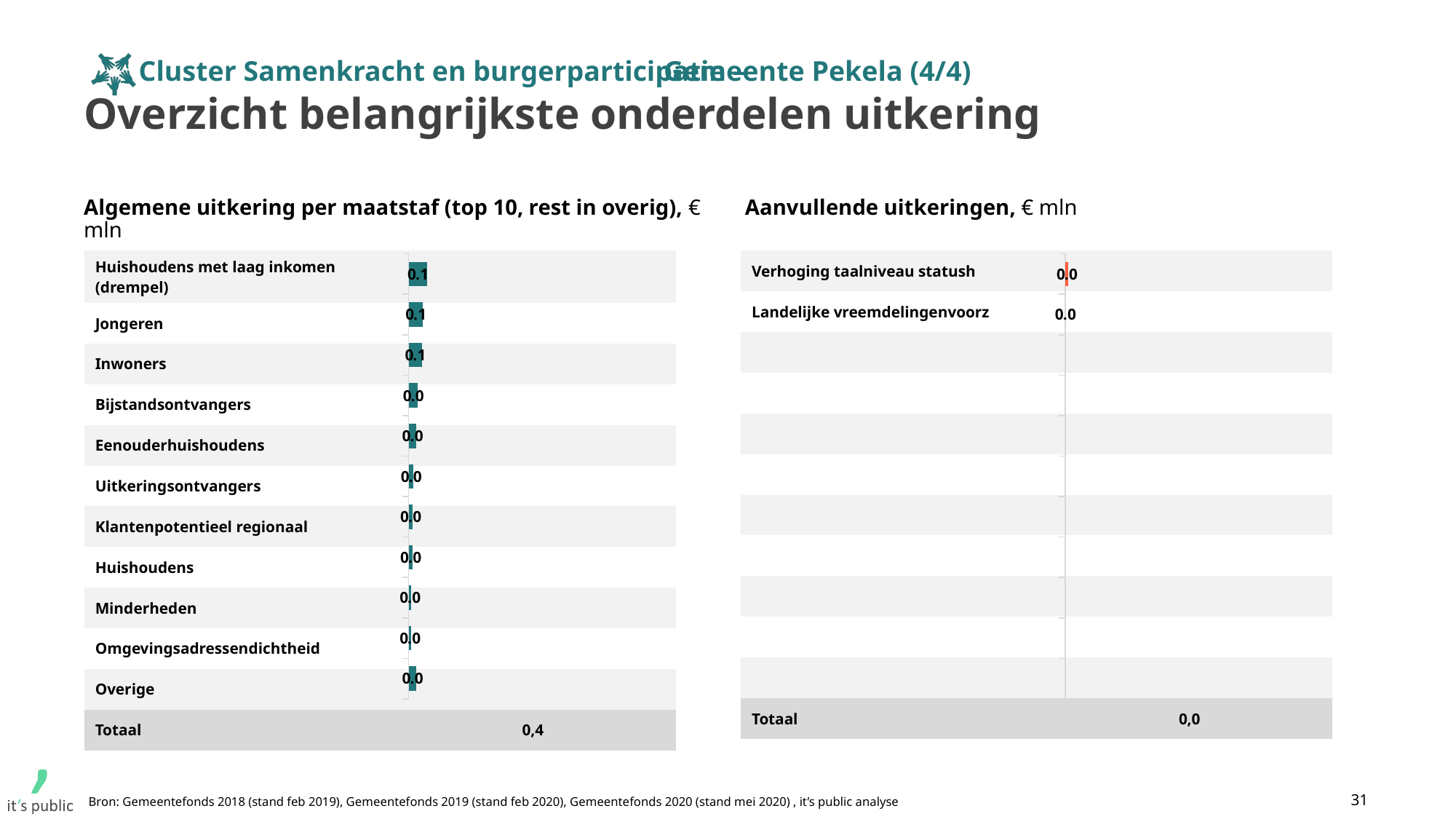
In the chart 'Algemene uitkering per maatstaf', which is larger: Huishoudens met laag inkomen (drempel) or Bijstandsontvangers? Huishoudens met laag inkomen (drempel) In the chart 'Algemene uitkering per maatstaf', what is the value for Jongeren? 0.1 In the chart 'Aanvullende uitkeringen', what is the Totaal shown? 0,0 How many categories (including Overige) are plotted in the chart 'Algemene uitkering per maatstaf'? 11 In the chart 'Aanvullende uitkeringen', what is the value for Landelijke vreemdelingenvoorz? 0.0 In the chart 'Algemene uitkering per maatstaf', what is the value for Overige? 0.0 How many categories are plotted in the chart 'Aanvullende uitkeringen'? 2 In the chart 'Aanvullende uitkeringen', what is the value for Verhoging taalniveau statush? 0.0 In the chart 'Algemene uitkering per maatstaf', what is the value for Huishoudens met laag inkomen (drempel)? 0.1 In the chart 'Algemene uitkering per maatstaf', what is the value for Bijstandsontvangers? 0.0 In the chart 'Algemene uitkering per maatstaf', what is the Totaal shown? 0,4 What kind of chart is 'Algemene uitkering per maatstaf'? Bar chart